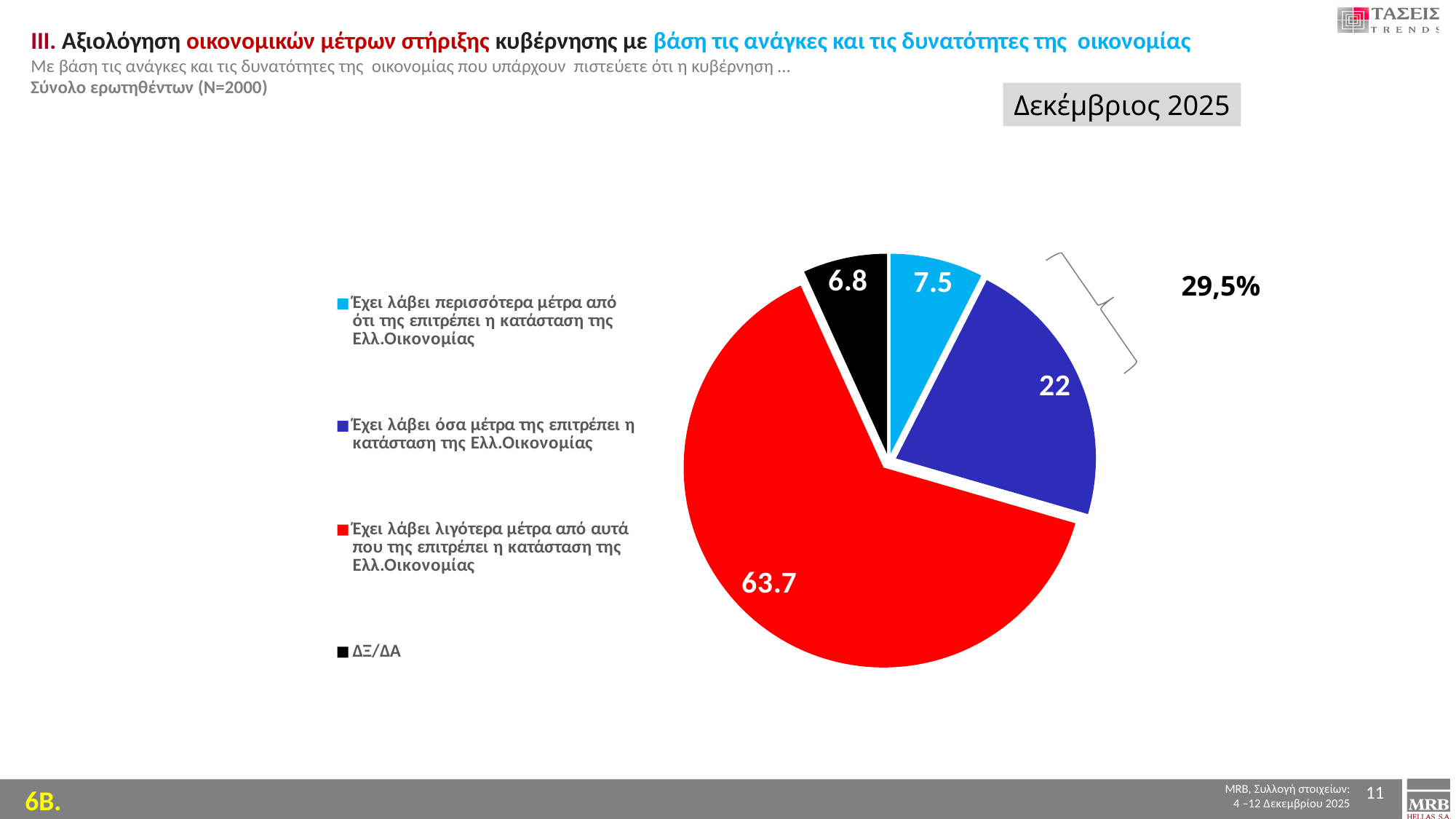
What type of chart is shown on the slide? Pie chart What is the value of the slice for 'Έχει λάβει περισσότερα μέτρα από ότι της επιτρέπει η κατάσταση της Ελλ.Οικονομίας'? 7.5 How many slices does the pie chart have? 4 What is the difference between the 'όσα μέτρα' slice and the 'περισσότερα μέτρα' slice? 14.5 Which category has the smallest slice of the pie? ΔΞ/ΔΑ Which category has the largest slice of the pie? Έχει λάβει λιγότερα μέτρα από αυτά που της επιτρέπει η κατάσταση της Ελλ.Οικονομίας What combined percentage is shown by the bracket next to the 'περισσότερα μέτρα' and 'όσα μέτρα' slices? 29,5% What is the difference between the 'λιγότερα μέτρα' slice (63.7) and the 'όσα μέτρα' slice (22)? 41.7 What is the value of the 'ΔΞ/ΔΑ' slice? 6.8 What is the value of the slice for 'Έχει λάβει λιγότερα μέτρα από αυτά που της επιτρέπει η κατάσταση της Ελλ.Οικονομίας'? 63.7 Which is larger: the 'περισσότερα μέτρα' slice or the 'ΔΞ/ΔΑ' slice? Έχει λάβει περισσότερα μέτρα από ότι της επιτρέπει η κατάσταση της Ελλ.Οικονομίας What is the value of the slice for 'Έχει λάβει όσα μέτρα της επιτρέπει η κατάσταση της Ελλ.Οικονομίας'? 22